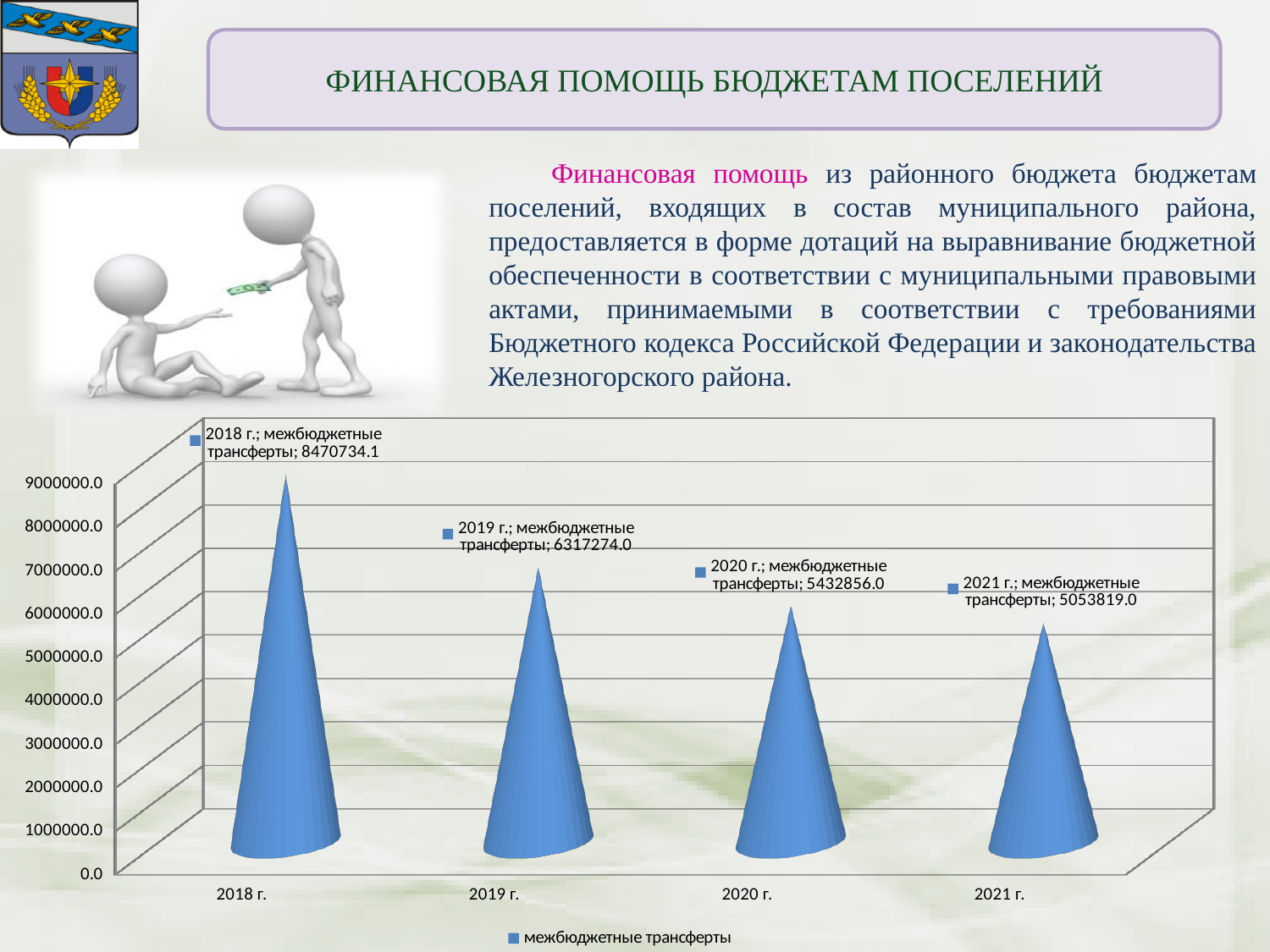
What is the difference between the values for 2020 г. and 2021 г.? 379037.0 Do the values rise or fall from 2018 г. to 2021 г.? fall What is the value for 2018 г. in the chart? 8470734.1 How many years are shown on the x axis of the chart? 4 What is the value for 2021 г. in the chart? 5053819.0 How many series does the chart legend list? 1 Which year has the lowest value in the chart? 2021 г. Which year has the highest value in the chart? 2018 г. Which is larger, the value for 2019 г. or the value for 2020 г.? 2019 г. What is the value for 2020 г. in the chart? 5432856.0 What is the difference between the values for 2018 г. and 2019 г.? 2153460.1 What is the value for 2019 г. in the chart? 6317274.0